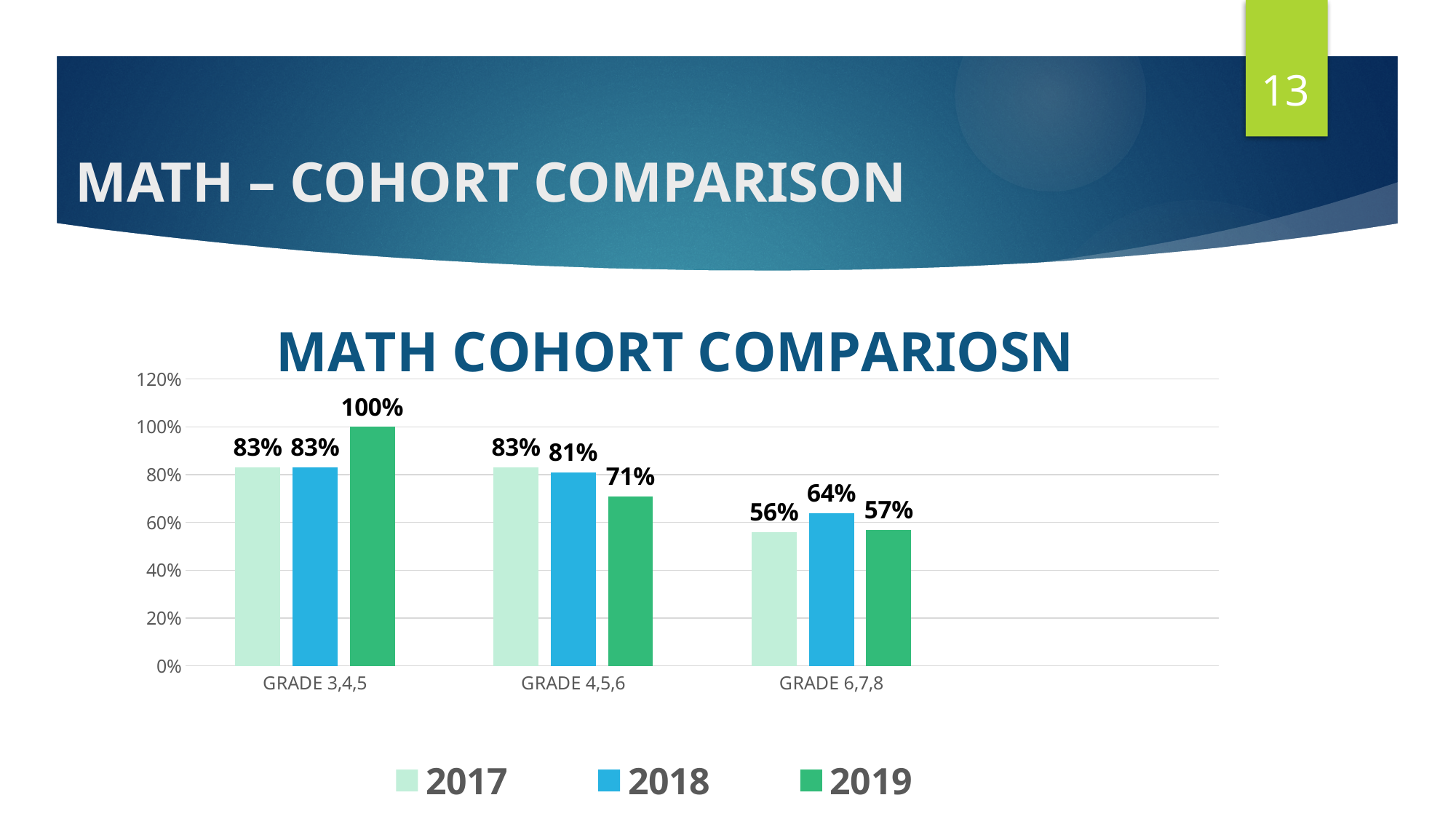
How many categories are shown on the x axis? 3 Which category has the highest value for the 2019 series? GRADE 3,4,5 Which is larger in the GRADE 6,7,8 category: the 2018 value or the 2019 value? 2018 What is the value for 2018 in the GRADE 6,7,8 category? 64% Which category has the lowest value for the 2017 series? GRADE 6,7,8 What kind of chart is shown on the slide? Bar chart How many series does the legend list? 3 What is the title of the chart? MATH COHORT COMPARIOSN What is the value for 2019 in the GRADE 3,4,5 category? 100% Do the 2019 values rise or fall from GRADE 3,4,5 to GRADE 6,7,8? Fall What is the value for 2017 in the GRADE 4,5,6 category? 83% What is the difference between the 2019 values for GRADE 3,4,5 and GRADE 4,5,6? 29%